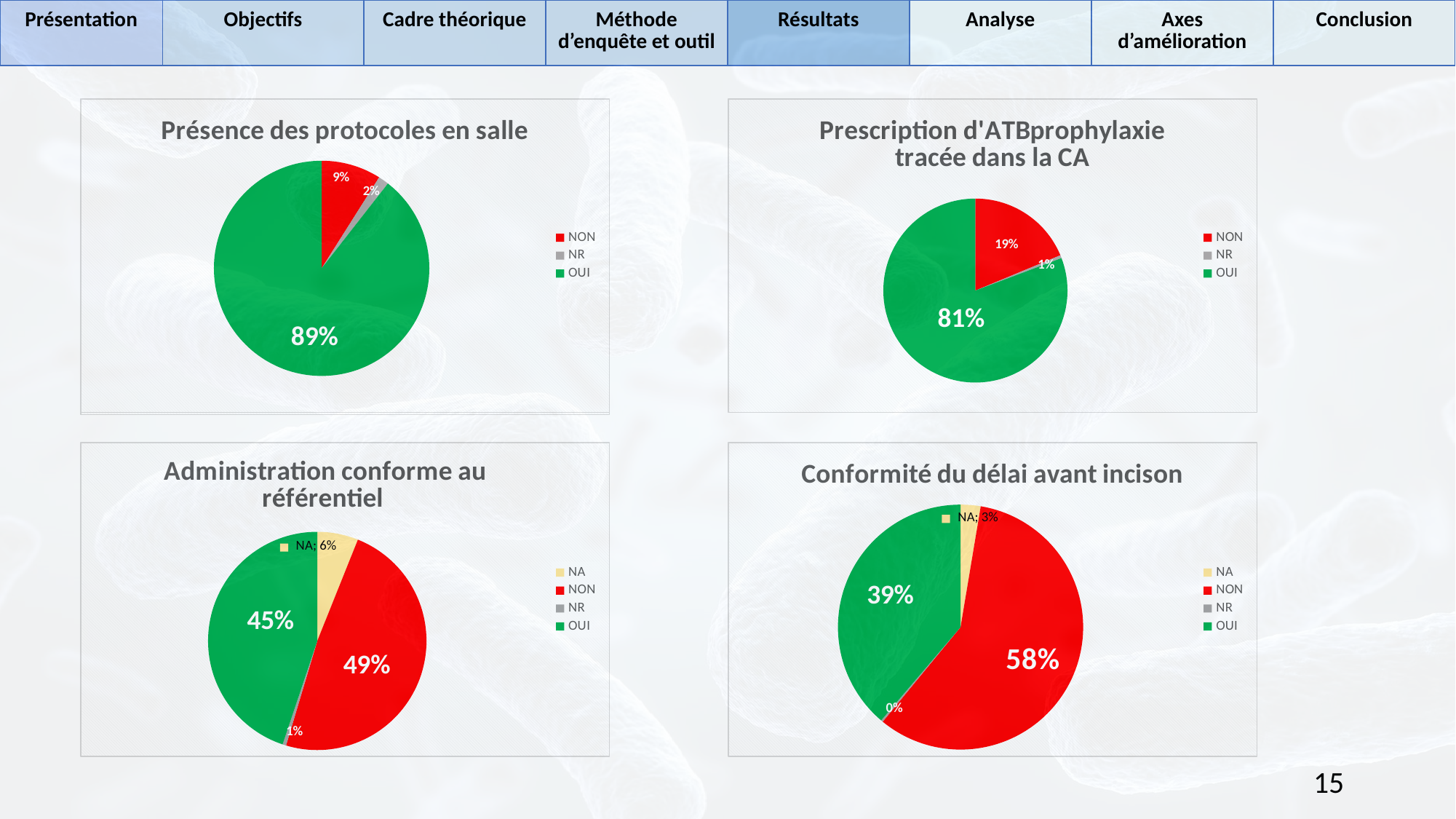
In the 'Présence des protocoles en salle' chart, which category has the smallest slice? NR In the 'Conformité du délai avant incison' chart, what is the value for NON? 58% What type of chart is the 'Conformité du délai avant incison' chart? Pie chart In the 'Administration conforme au référentiel' chart, what is the difference between NON and OUI? 4% In the 'Présence des protocoles en salle' chart, what share of the pie is OUI? 89% In the 'Administration conforme au référentiel' chart, which is larger, NON or OUI? NON In the 'Présence des protocoles en salle' chart, what is the value for NON? 9% In the 'Administration conforme au référentiel' chart, what is the value for NA? 6% In the 'Conformité du délai avant incison' chart, which category has the largest slice? NON In the 'Prescription d'ATBprophylaxie tracée dans la CA' chart, what is the difference between OUI and NON? 62% How many series does the legend list in the 'Prescription d'ATBprophylaxie tracée dans la CA' chart? 3 In the 'Prescription d'ATBprophylaxie tracée dans la CA' chart, what is the value for NON? 19%